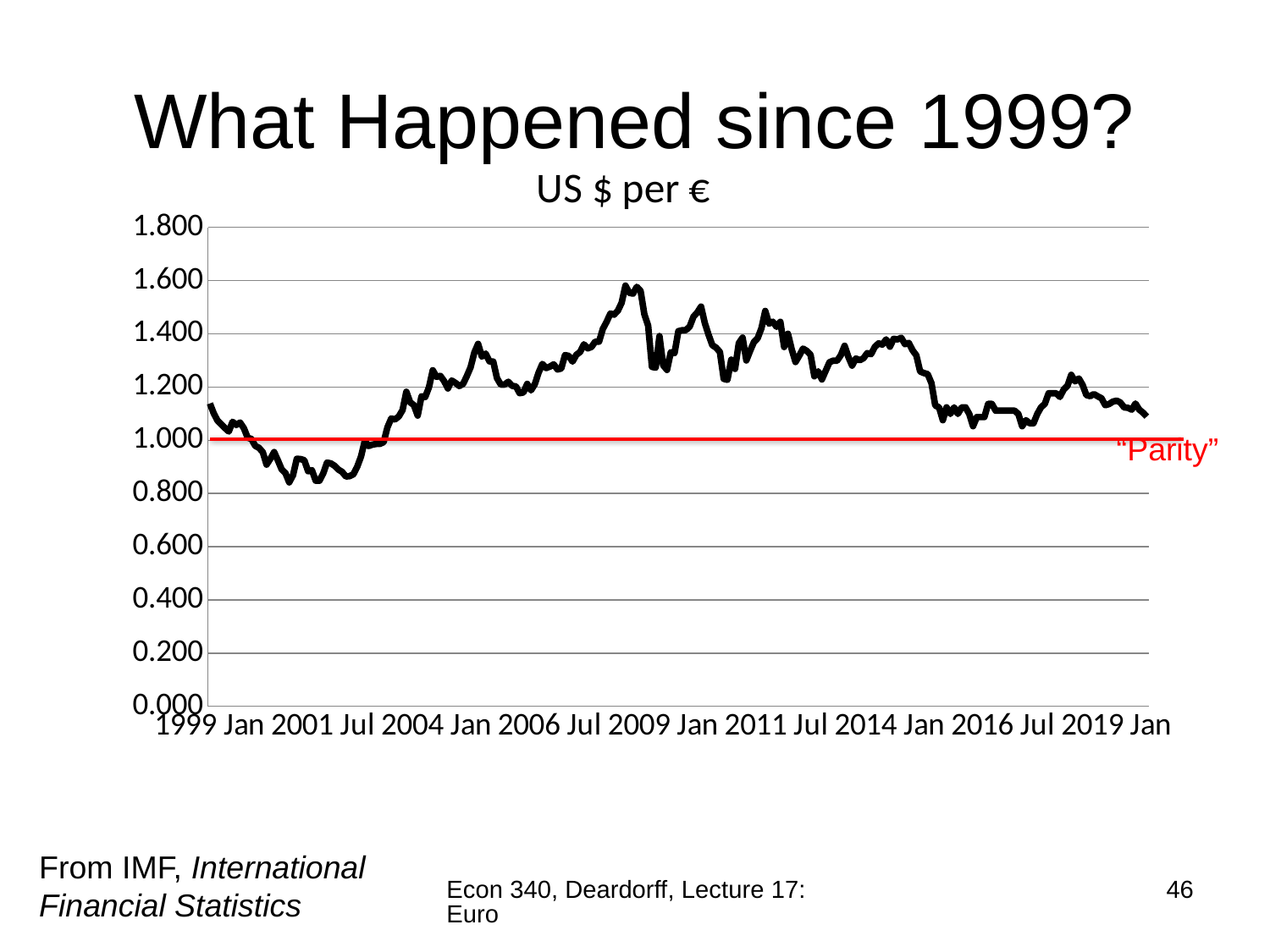
How many date labels are shown on the x axis? 9 Is the highest value reached by the line greater or less than 1.400? greater What is the title of the chart? US $ per € Is the value for 2016 Jul greater or less than 1.200? less Does the line rise or fall between 2014 Jan and 2016 Jul? fall Does the line rise or fall between 2001 Jul and 2006 Jul? rise What does the red horizontal line on the chart represent? "Parity" Is the lowest value reached by the line greater or less than 1.000? less What kind of chart is shown on the slide? line chart